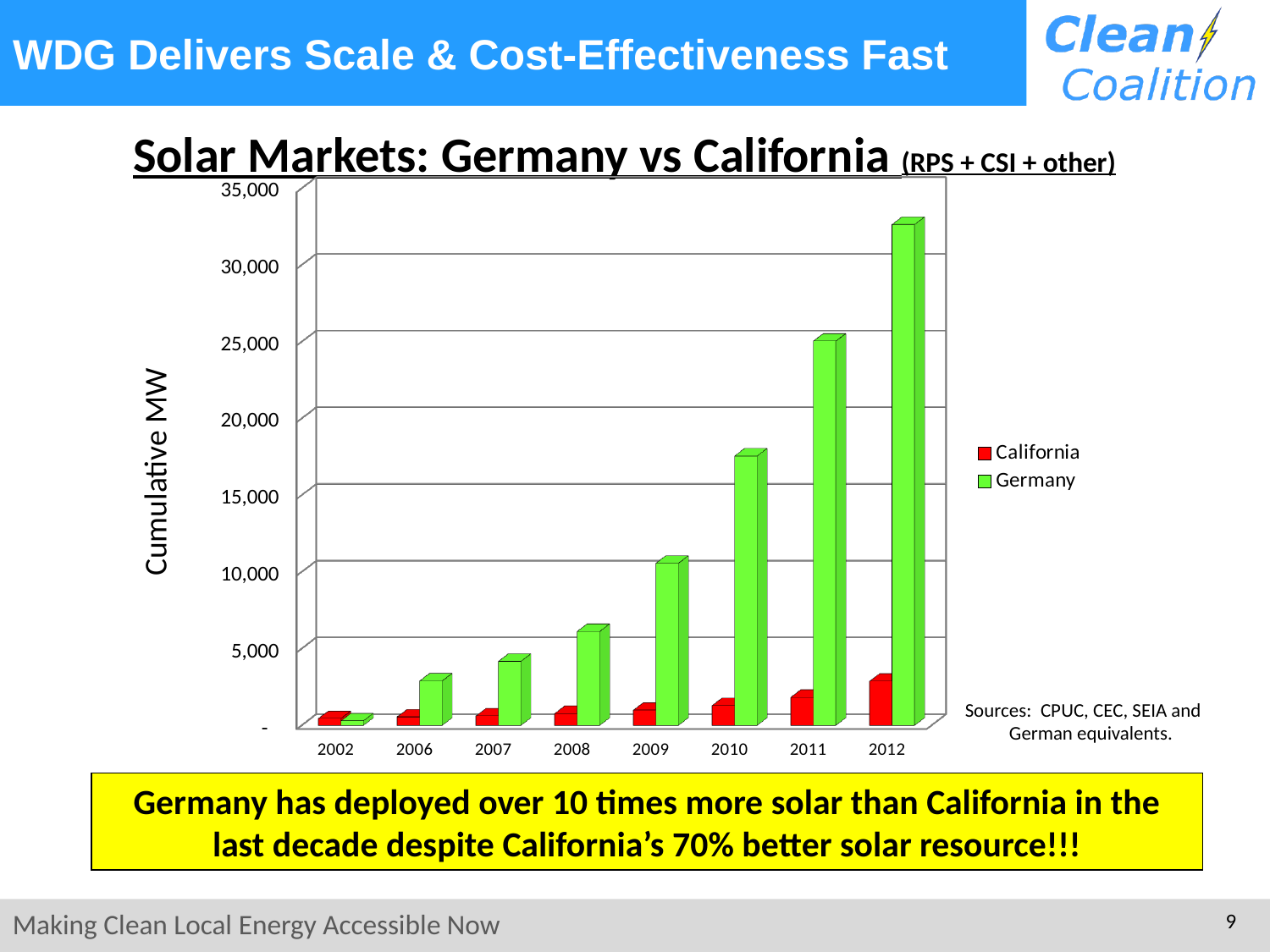
How many series does the legend list? 2 In which year is the Germany bar the lowest? 2002 Do the Germany values rise or fall from 2002 to 2012? rise Is the value for California in 2012 greater or less than 5,000? less In which year is the Germany bar the highest? 2012 Is the value for Germany in 2012 greater or less than 30,000? greater What kind of chart is shown on the slide? bar chart What is the label on the vertical axis of the chart? Cumulative MW How many years are shown on the x axis of the chart? 8 Is the value for Germany in 2007 greater or less than 5,000? less In 2012, which is larger, the value for Germany or the value for California? Germany